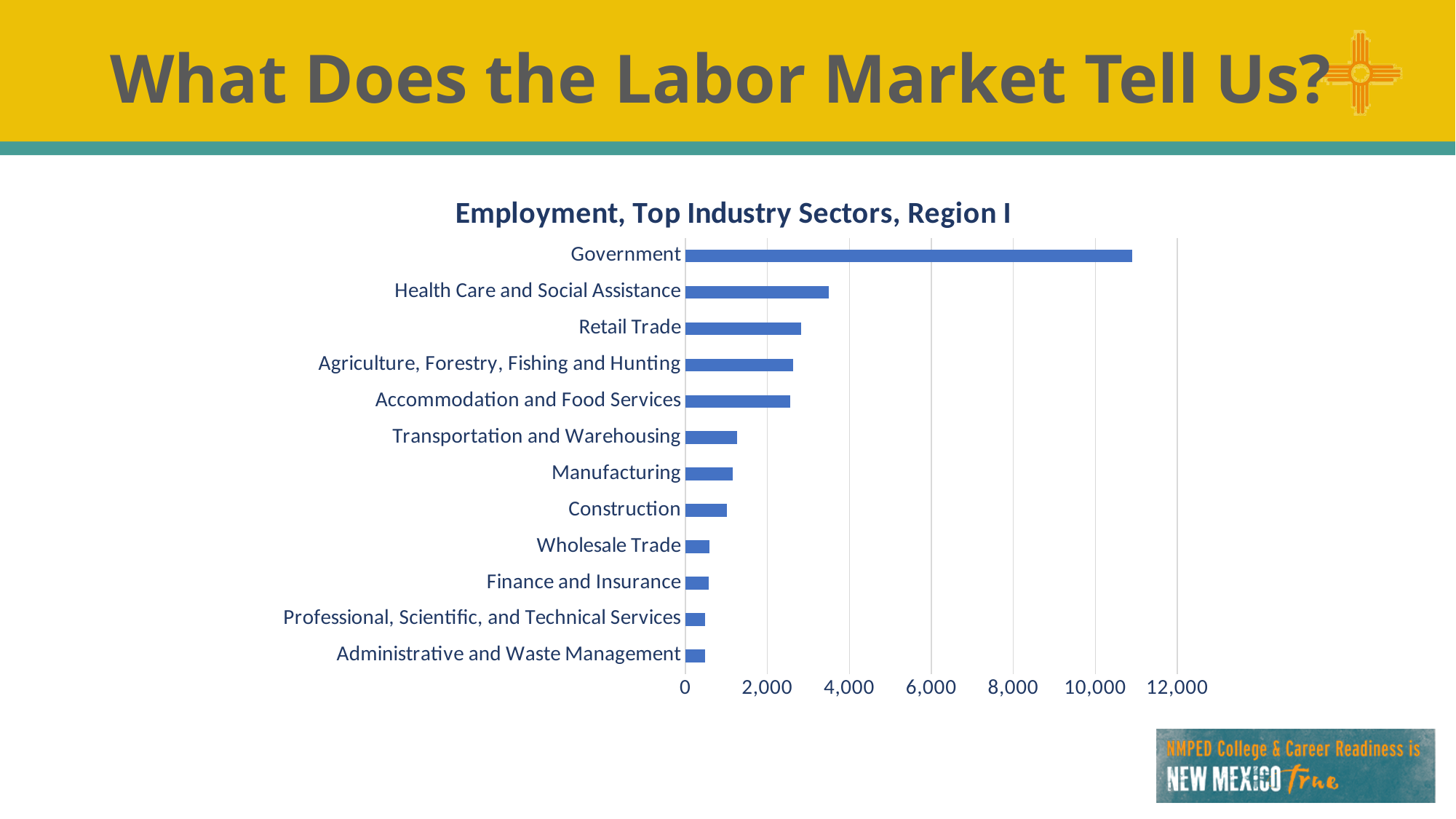
Is the employment value for Wholesale Trade greater or less than 2,000? less What is the title of the chart? Employment, Top Industry Sectors, Region I Which industry sector has the highest employment? Government Is the employment value for Health Care and Social Assistance greater or less than 4,000? less What is the highest value shown on the horizontal axis of the chart? 12,000 Is the employment value for Government greater or less than 10,000? greater Which has higher employment, Government or Health Care and Social Assistance? Government Which has higher employment, Transportation and Warehousing or Wholesale Trade? Transportation and Warehousing How many industry sectors are shown in the chart? 12 What kind of chart is shown on the slide? bar chart Which has higher employment, Health Care and Social Assistance or Retail Trade? Health Care and Social Assistance